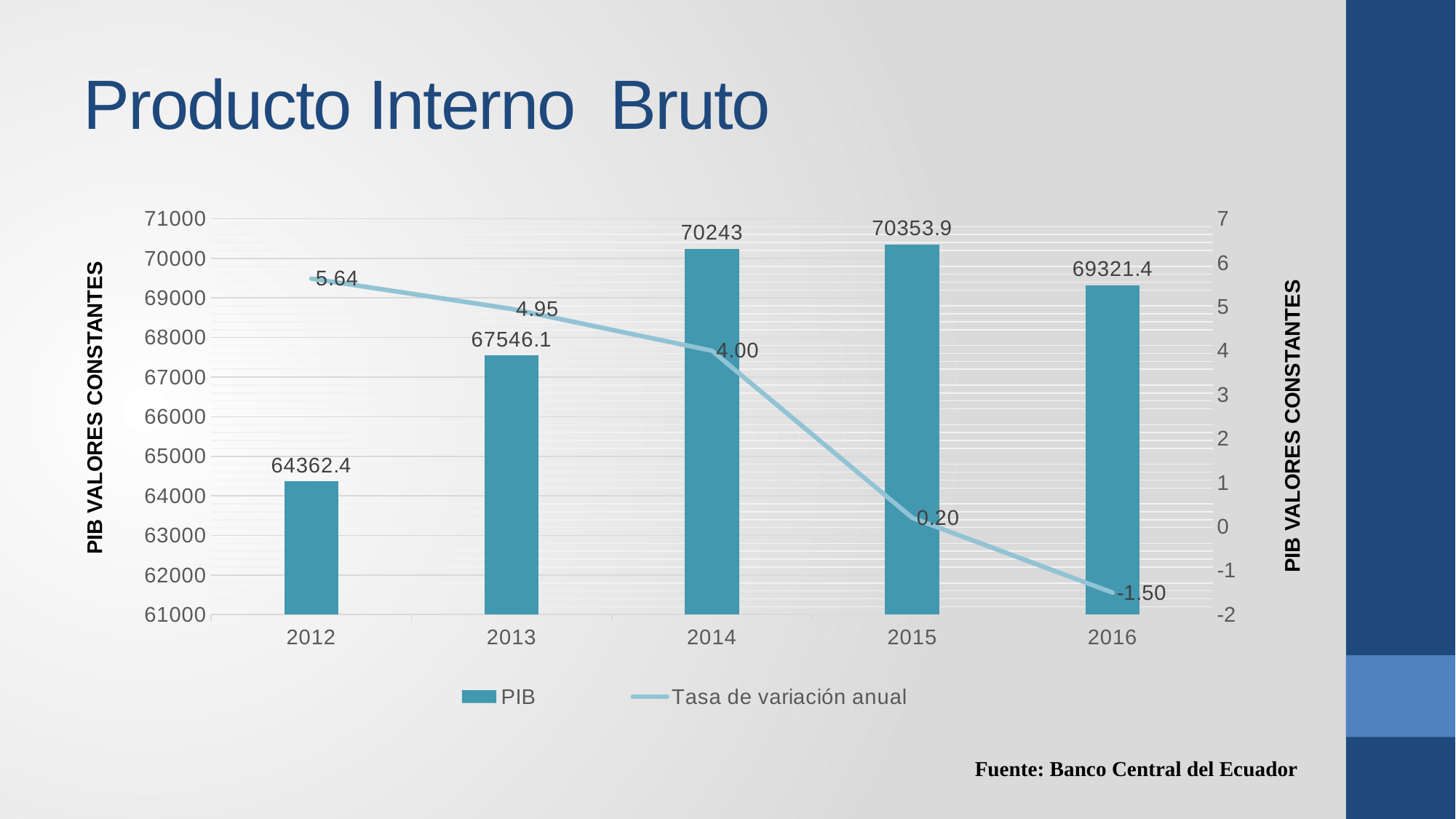
How many years are shown on the x axis? 5 What is the difference between the PIB values for 2015 and 2016? 1032.5 Which is larger, the PIB value for 2013 or for 2016? 2016 Which year has the highest PIB value? 2015 How many series does the legend list? 2 Does the Tasa de variación anual rise or fall from 2012 to 2016? fall Which year has the lowest Tasa de variación anual? 2016 What is the Tasa de variación anual for 2016? -1.50 What is the source cited below the chart? Banco Central del Ecuador What is the PIB value for 2014? 70243 What is the Tasa de variación anual for 2013? 4.95 What is the PIB value for 2012? 64362.4